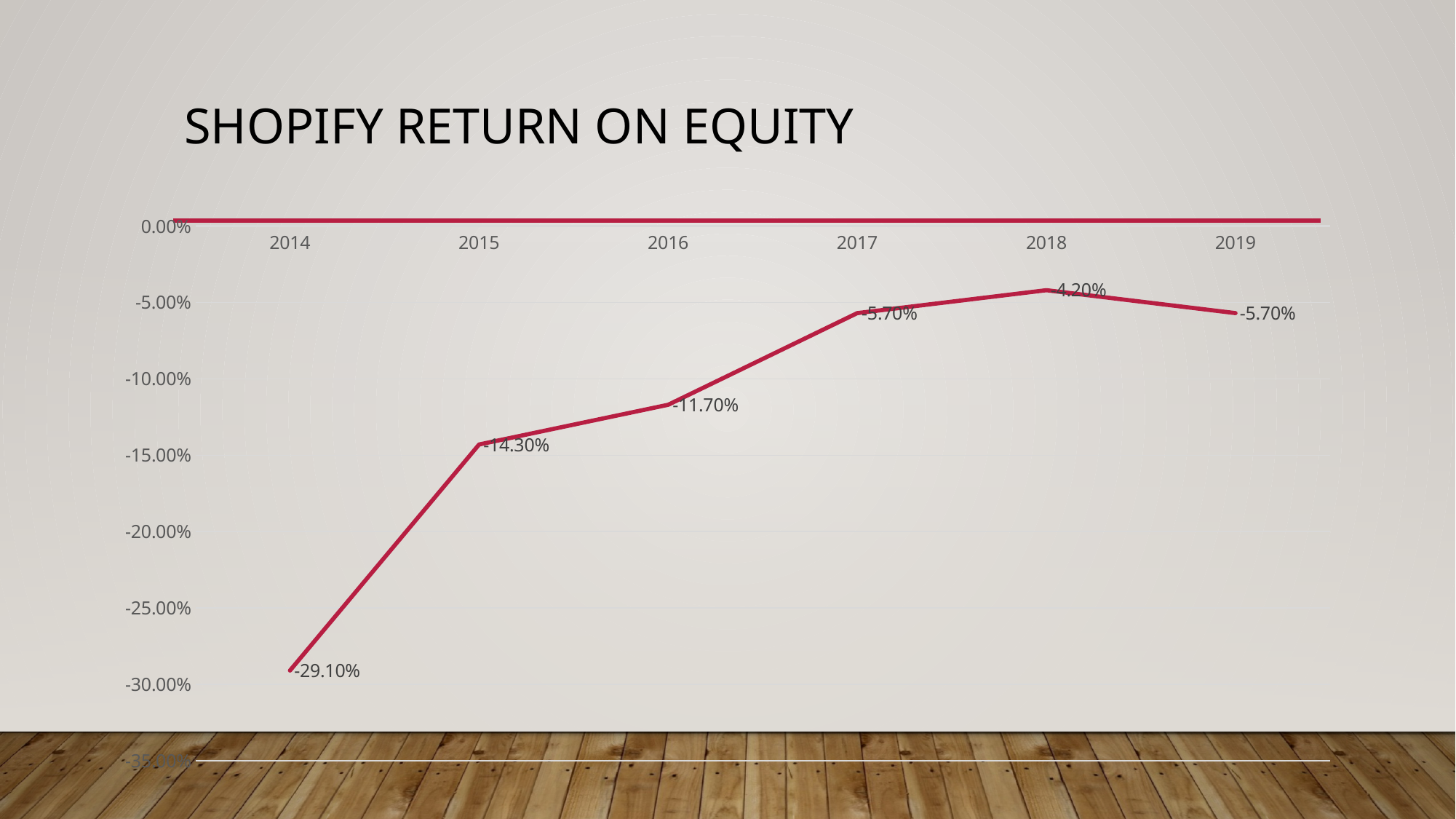
What is the difference between the return on equity in 2018 and 2019? 1.50% How many years are plotted on the chart? 6 What is the return on equity for 2014? -29.10% Which year has a higher return on equity, 2015 or 2016? 2016 What kind of chart is shown on the slide? line chart Is the value for 2014 greater or less than -25.00%? less Which year has the highest return on equity? 2018 What is the return on equity for 2016? -11.70% What is the difference between the return on equity in 2015 and 2014? 14.80% What is the return on equity for 2018? -4.20% Which year has the lowest return on equity? 2014 What is the title of the chart? SHOPIFY RETURN ON EQUITY